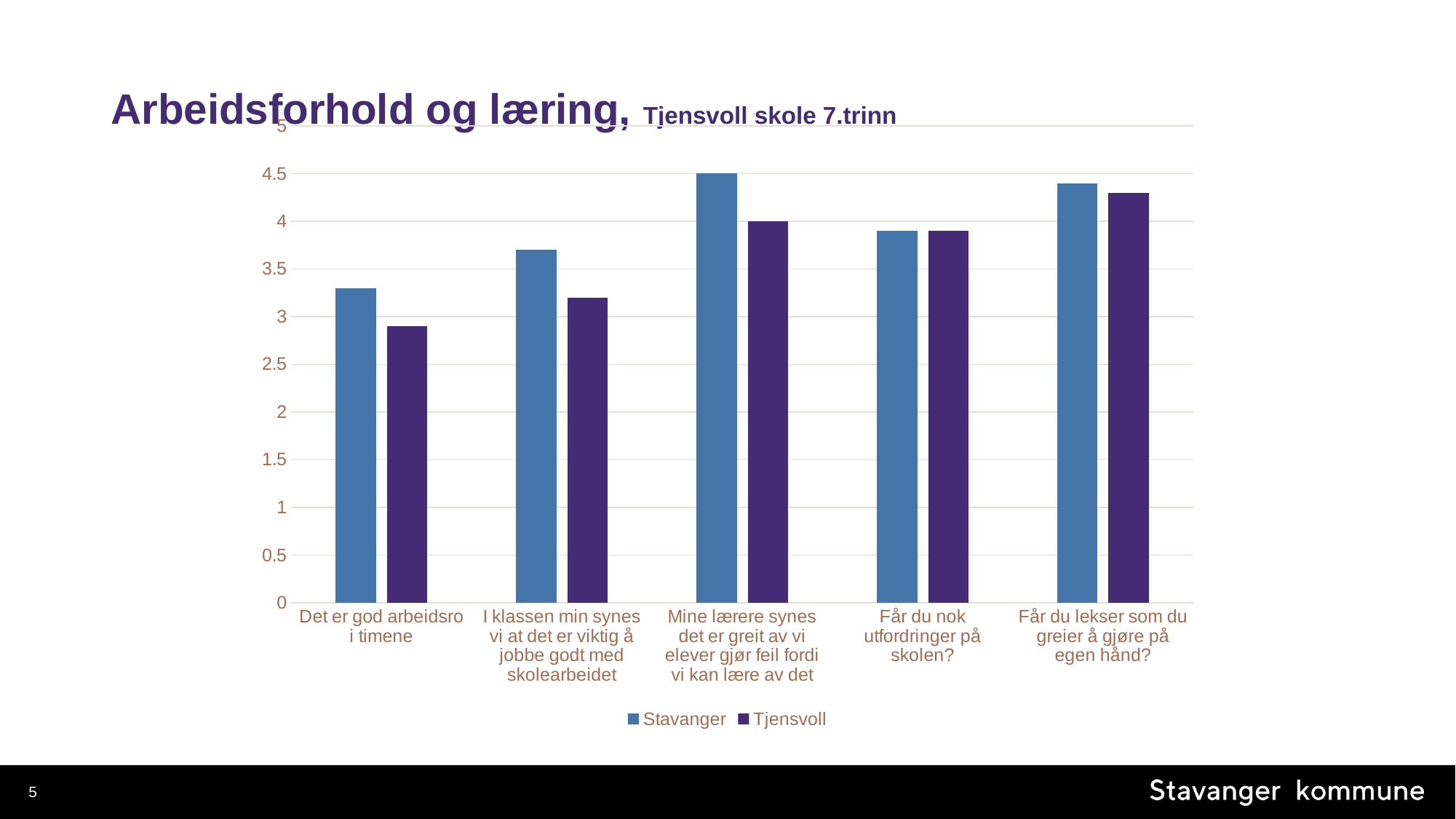
How many categories are shown on the x axis? 5 What is the Tjensvoll value for "Mine lærere synes det er greit av vi elever gjør feil fordi vi kan lære av det"? 4 Is the Stavanger value for "I klassen min synes vi at det er viktig å jobbe godt med skolearbeidet" greater or less than 3.5? greater Which category has the lowest Tjensvoll value? Det er god arbeidsro i timene Which category has the highest Stavanger value? Mine lærere synes det er greit av vi elever gjør feil fordi vi kan lære av det What kind of chart is shown on the slide? bar chart Which series is shown in dark purple in the legend? Tjensvoll What is the Stavanger value for "Mine lærere synes det er greit av vi elever gjør feil fordi vi kan lære av det"? 4.5 Is the Tjensvoll value for "Det er god arbeidsro i timene" greater or less than 3? less Is the Tjensvoll value for "Får du lekser som du greier å gjøre på egen hånd?" greater or less than 4? greater For "Det er god arbeidsro i timene", which is larger, the Stavanger value or the Tjensvoll value? Stavanger How many series does the legend list? 2